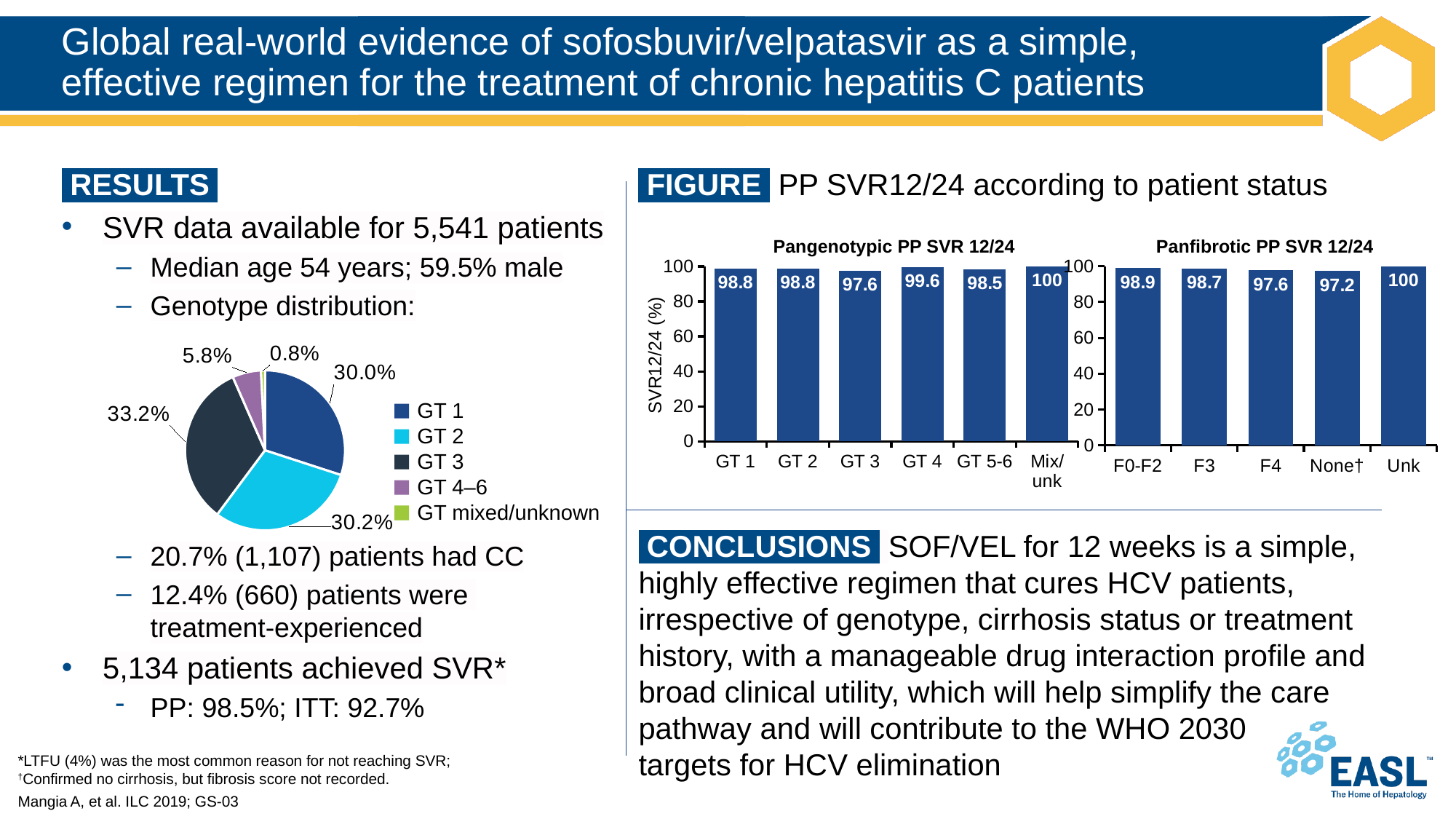
In the Panfibrotic PP SVR 12/24 chart, what kind of chart is used? Bar chart In the genotype distribution pie chart, how many entries does the legend list? 5 In the Panfibrotic PP SVR 12/24 chart, what is the difference between the values for F0-F2 and F4? 1.3 In the Pangenotypic PP SVR 12/24 chart, how many categories are shown on the x axis? 6 In the Pangenotypic PP SVR 12/24 chart, what is the value for GT 4? 99.6 In the genotype distribution pie chart, which is larger, the share for GT 1 or the share for GT 4–6? GT 1 In the Pangenotypic PP SVR 12/24 chart, which category has the highest value? Mix/unk In the Panfibrotic PP SVR 12/24 chart, which category has the lowest value? None† In the Panfibrotic PP SVR 12/24 chart, what is the value for F3? 98.7 In the genotype distribution pie chart, which genotype has the smallest slice? GT mixed/unknown In the Pangenotypic PP SVR 12/24 chart, which category has the lowest value? GT 3 In the genotype distribution pie chart, what share does GT 3 have? 33.2%